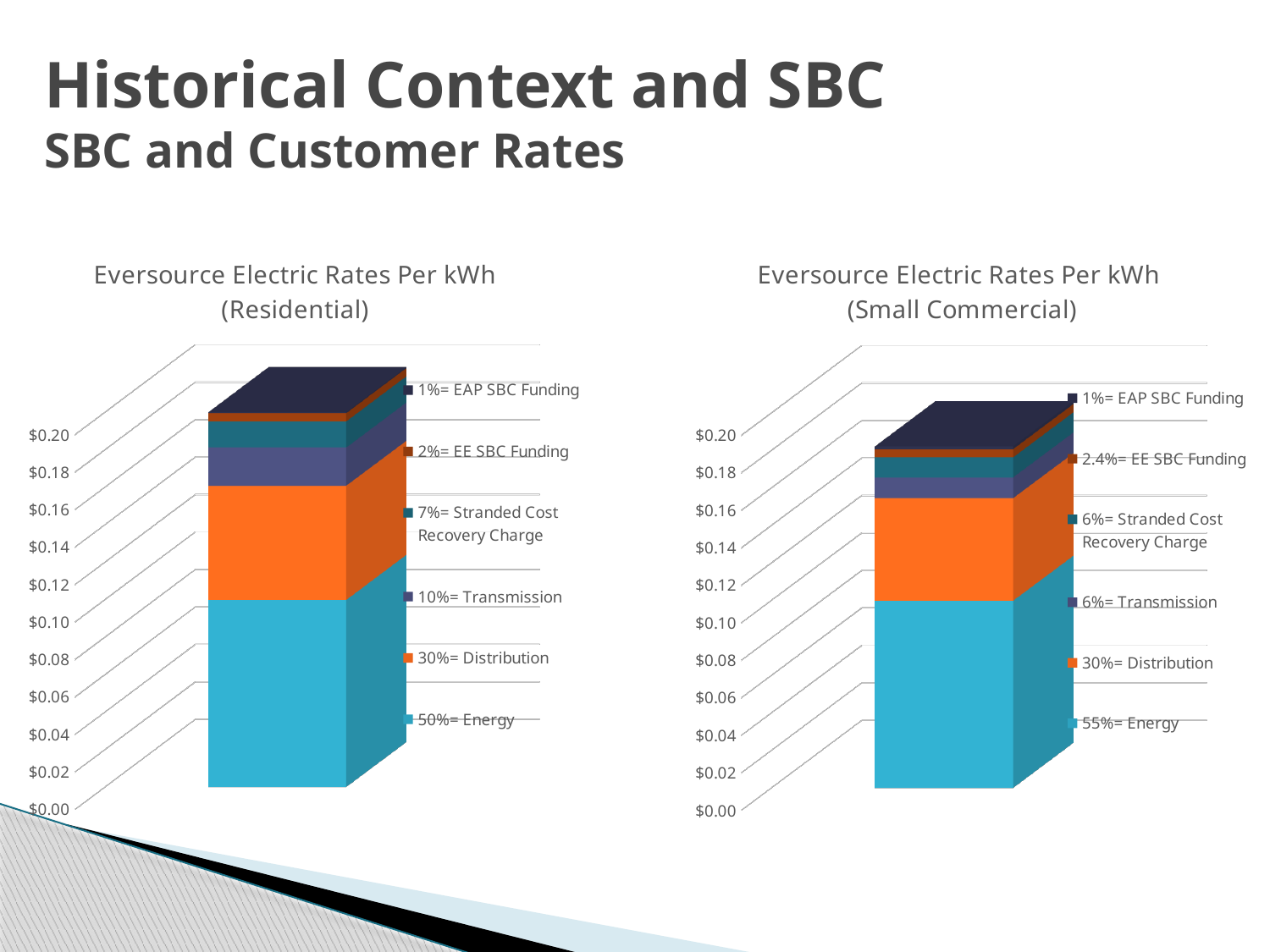
On the Residential chart, what percentage does the legend give for Energy? 50% Which component has the largest percentage on the Small Commercial chart? Energy Which component has the smallest percentage on the Residential chart? EAP SBC Funding Is the Energy percentage larger on the Residential chart or the Small Commercial chart? Small Commercial How many series does the legend list on the Eversource Electric Rates Per kWh (Small Commercial) chart? 6 On the Small Commercial chart, what percentage does the legend give for EE SBC Funding? 2.4% On the Residential chart, what percentage does the legend give for Transmission? 10% What kind of chart is the Eversource Electric Rates Per kWh (Residential) chart? Stacked bar chart On the Residential chart, what percentage does the legend give for Stranded Cost Recovery Charge? 7% On the Small Commercial chart, what percentage does the legend give for Energy? 55% How many series does the legend list on the Eversource Electric Rates Per kWh (Residential) chart? 6